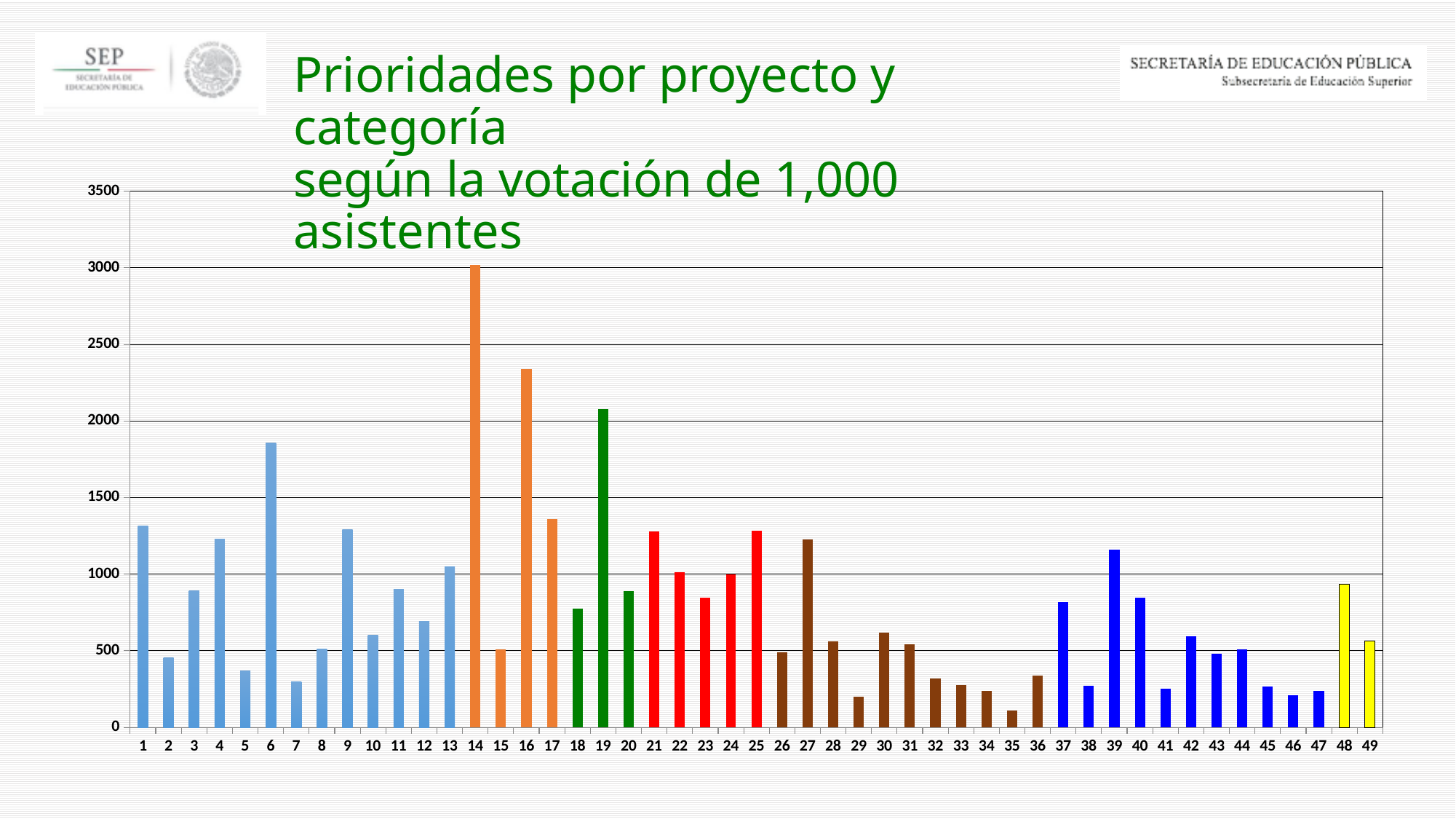
Is the value for category 6 greater or less than 1500? greater Which category has the lowest value? 35 How many categories are plotted along the x axis? 49 Which has a larger value, category 29 or category 30? 30 Which has a larger value, category 14 or category 16? 14 Which category has the highest value? 14 Is the value for category 39 greater or less than 1000? greater What colour are the bars for categories 48 and 49? yellow Is the value for category 35 greater or less than 500? less What kind of chart is shown on the slide? bar chart